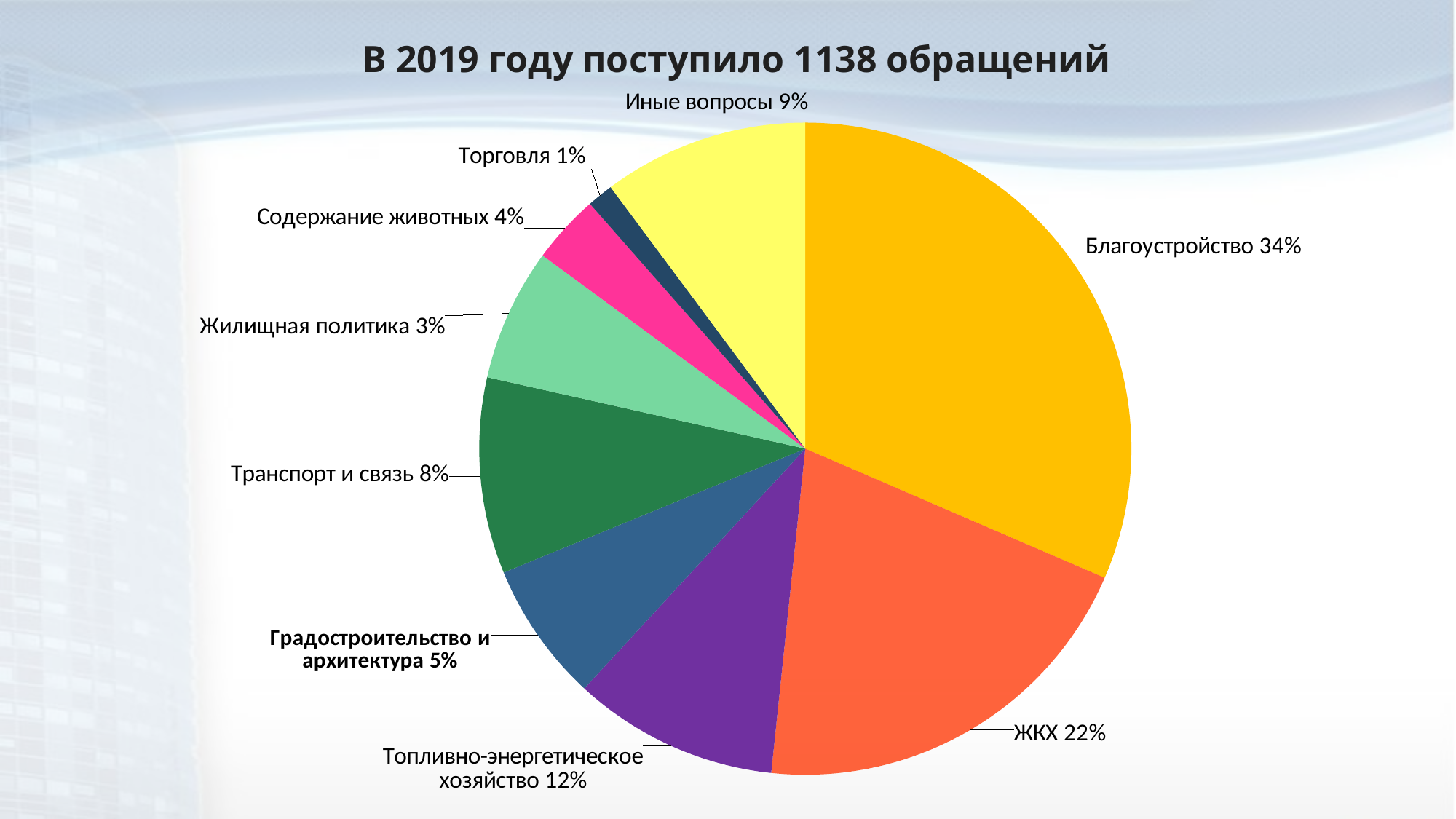
Which category has the largest slice of the pie? Благоустройство What share of the pie does ЖКХ have? 22% How many slices does the pie chart have? 9 What is the combined share of Содержание животных and Жилищная политика? 7% What is the title of the slide? В 2019 году поступило 1138 обращений What share of the pie does Транспорт и связь have? 8% What is the difference in percentage points between Благоустройство and ЖКХ? 12 What kind of chart is shown on the slide? pie chart What share of the pie does Топливно-энергетическое хозяйство have? 12% Which category has the smallest slice of the pie? Торговля What share of the pie does Благоустройство have? 34% Which is larger, the share for Иные вопросы or the share for Транспорт и связь? Иные вопросы